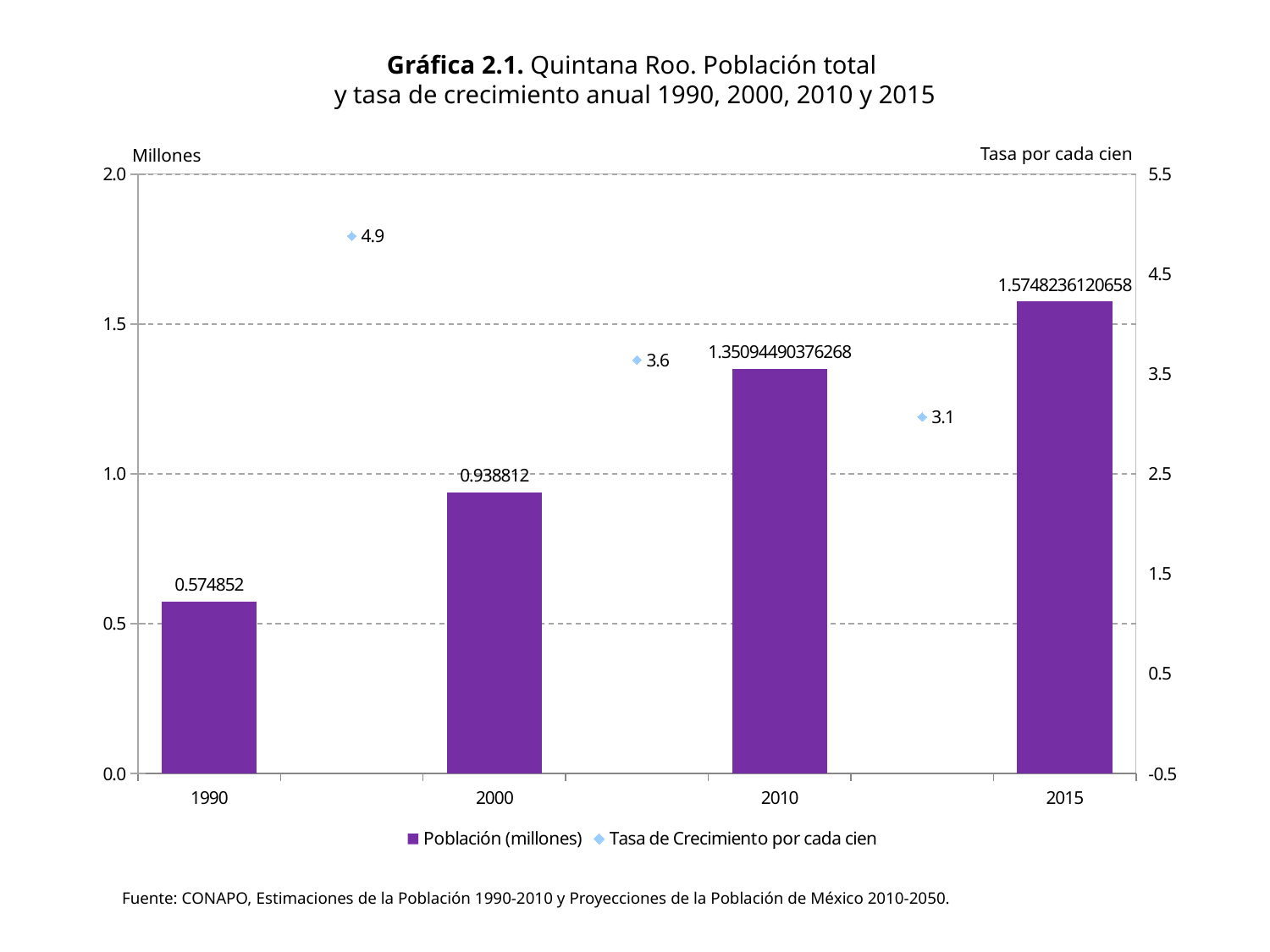
Which year has the lowest Población (millones)? 1990 Does the Población (millones) rise or fall from 1990 to 2015? rise What is the value of Población (millones) for 2015? 1.5748236120658 Which is larger, the Población (millones) for 2010 or for 2000? 2010 What is the lowest Tasa de Crecimiento por cada cien value shown on the chart? 3.1 What is the value of Población (millones) for 2000? 0.938812 What is the difference between the Población (millones) values for 2000 and 1990? 0.36396 Which year has the highest Población (millones)? 2015 What is the value of Población (millones) for 1990? 0.574852 How many series does the legend list? 2 What is the highest Tasa de Crecimiento por cada cien value shown on the chart? 4.9 How many years are shown on the x axis? 4